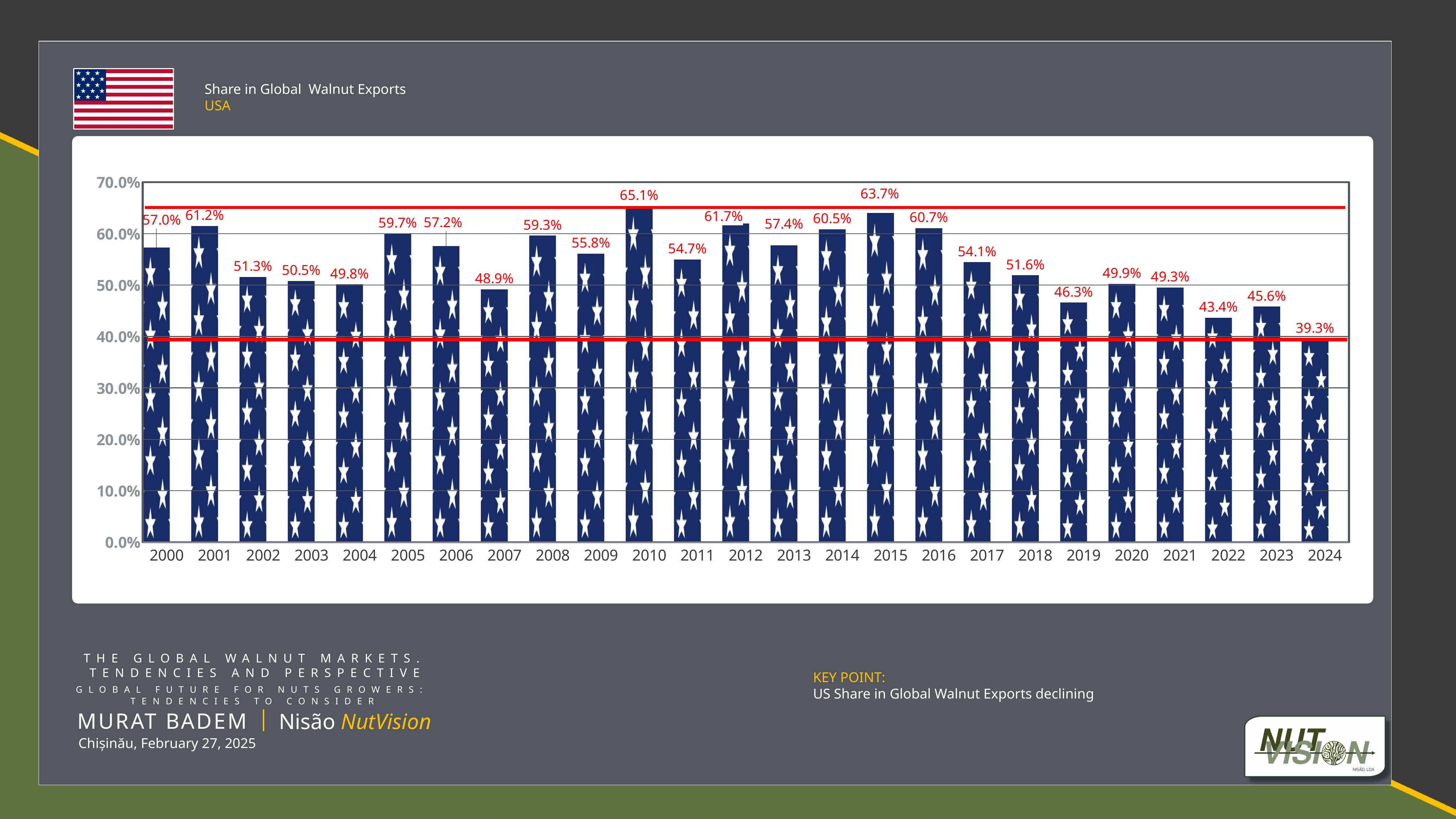
What is the difference between the US share in 2010 and in 2024? 25.8% What is the title of the chart on the slide? Share in Global Walnut Exports USA What kind of chart is used to show the US share in global walnut exports? bar chart Is the US share in global walnut exports for 2019 greater or less than 50.0%? less What is the US share in global walnut exports for 2015? 63.7% Which year has the highest US share in global walnut exports? 2010 Which year has a larger US share in global walnut exports, 2001 or 2016? 2001 Does the US share in global walnut exports generally rise or fall from 2015 to 2024? fall How many years are shown on the x axis of the chart? 25 What is the US share in global walnut exports for 2024? 39.3% Which year has the lowest US share in global walnut exports? 2024 What is the US share in global walnut exports for 2010? 65.1%